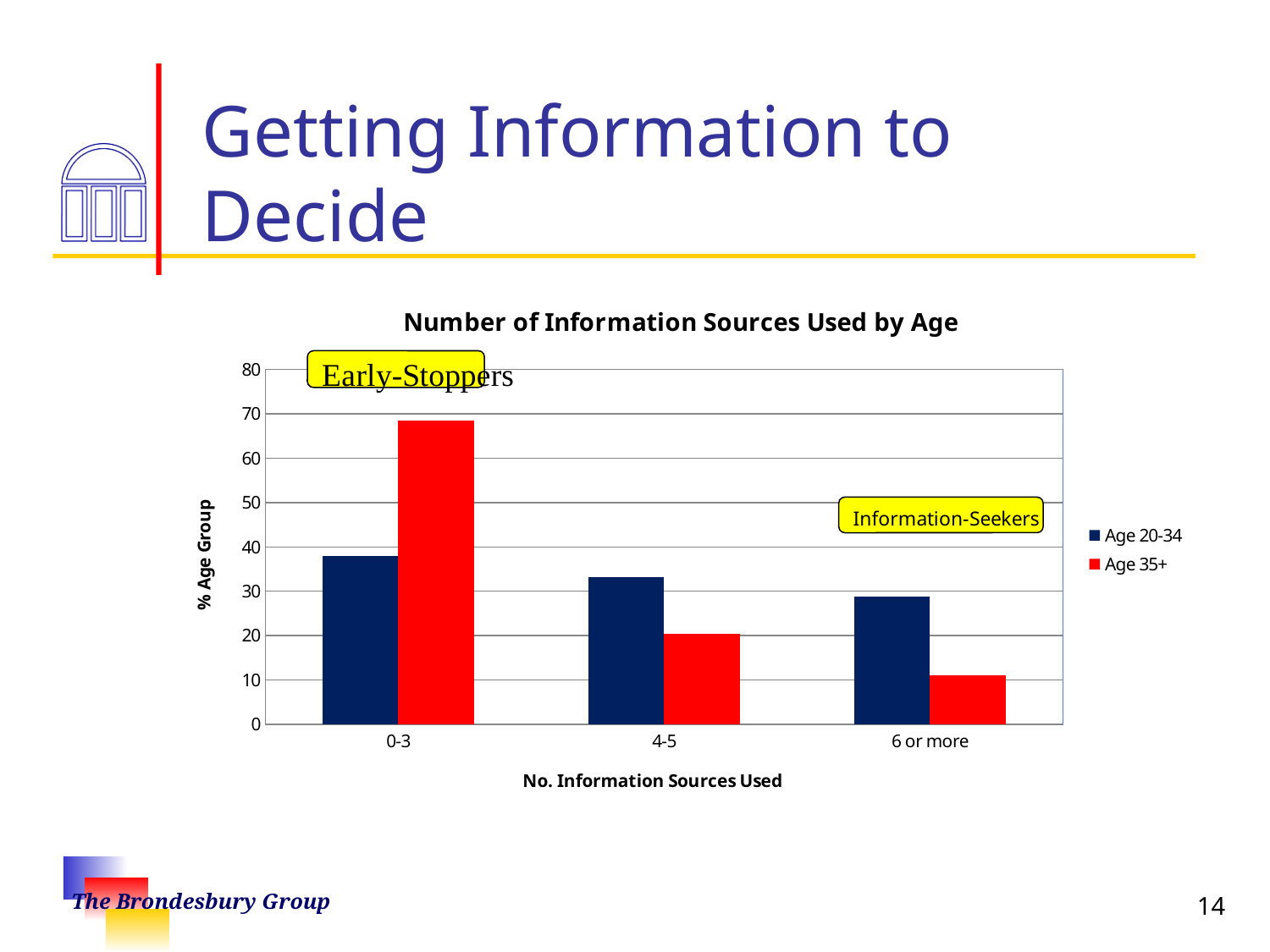
Is the value for Age 35+ in the 6 or more category greater or less than 20? less In the 6 or more category, which series has the larger value, Age 20-34 or Age 35+? Age 20-34 Which category has the highest value for Age 35+? 0-3 How many series does the legend list? 2 Which category has the lowest value for Age 35+? 6 or more Is the value for Age 35+ in the 0-3 category greater or less than 60? greater What is the title of the chart? Number of Information Sources Used by Age Which category has the highest value for Age 20-34? 0-3 How many categories are shown on the x axis? 3 What kind of chart is shown on the slide? bar chart Do the values for Age 35+ rise or fall from the 0-3 category to the 6 or more category? fall Is the value for Age 20-34 in the 4-5 category greater or less than 30? greater